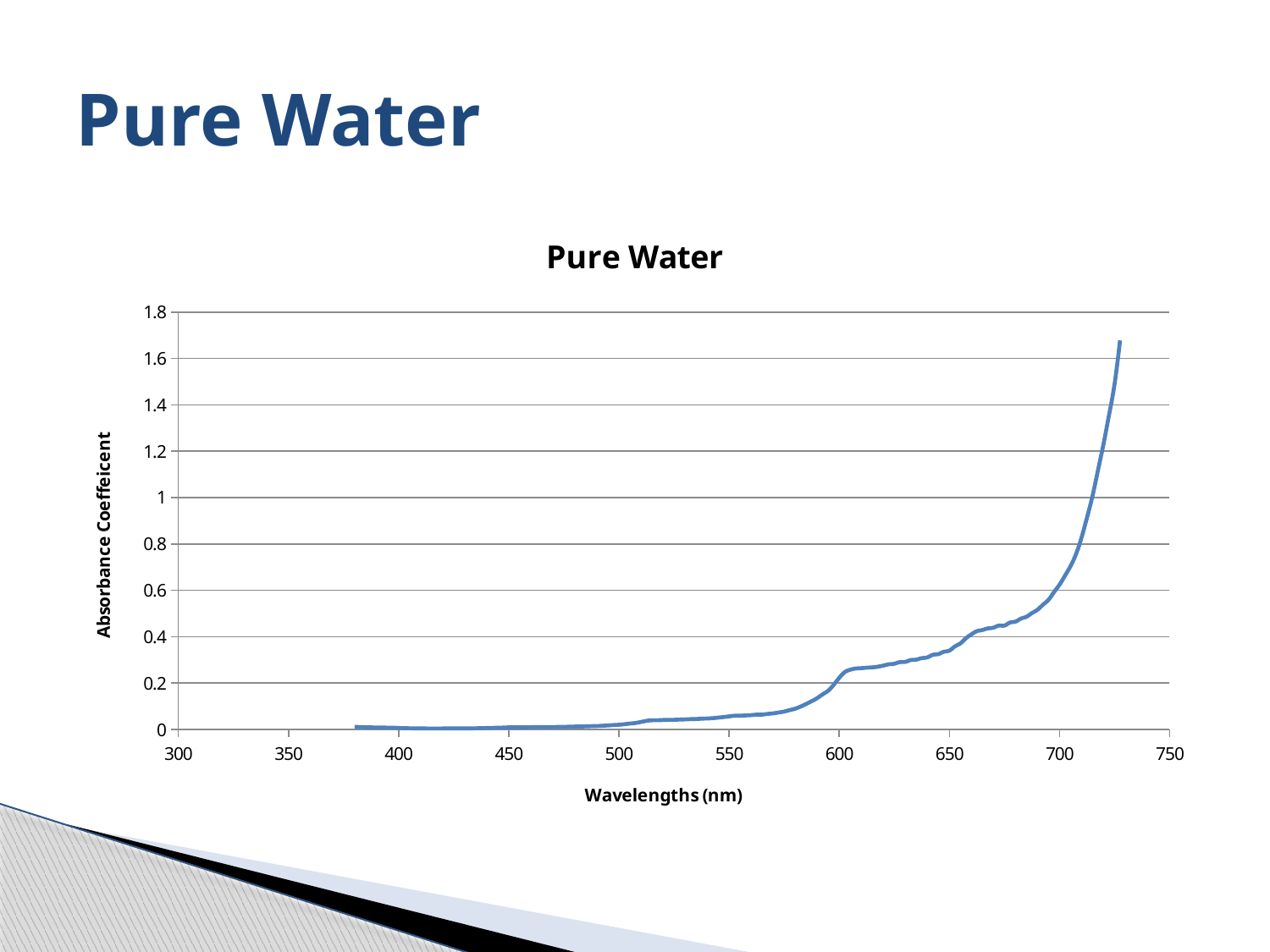
Is the absorbance coefficient at 720 nm greater or less than 0.8? greater What is the highest value shown on the y axis? 1.8 What is the label of the x axis of the chart? Wavelengths (nm) What kind of chart is shown on the slide? line chart Which wavelength has the higher absorbance coefficient, 650 nm or 550 nm? 650 nm Is the absorbance coefficient at 500 nm greater or less than 0.2? less Is the absorbance coefficient at 700 nm greater or less than 0.4? greater Does the absorbance coefficient rise or fall as wavelength increases along the x axis? rise What is the title of the chart? Pure Water How many data series are plotted on the chart? 1